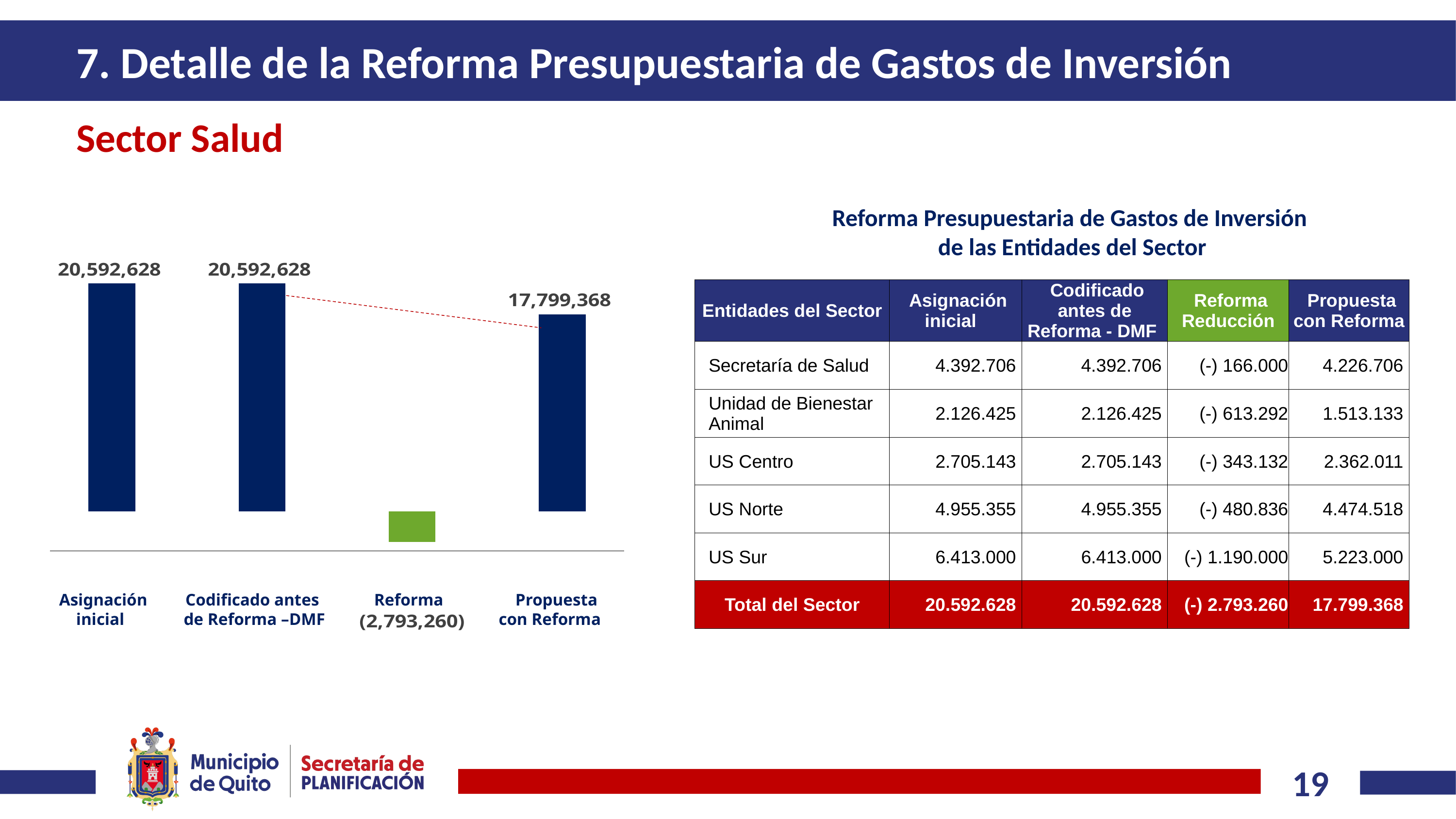
How many categories are plotted along the x axis of the chart? 4 What is the difference between the Codificado antes de Reforma –DMF value and the Propuesta con Reforma value in the chart? 2,793,260 What is the value shown for Codificado antes de Reforma –DMF in the chart? 20,592,628 Which is larger in the chart, Asignación inicial or Propuesta con Reforma? Asignación inicial Which category in the chart has the smallest bar? Reforma What is the value shown for Asignación inicial in the chart? 20,592,628 What is the value shown for Propuesta con Reforma in the chart? 17,799,368 What colour is the Reforma bar in the chart? Green What kind of chart is shown on the left of the slide? Bar chart Does the value fall or rise from Codificado antes de Reforma –DMF to Propuesta con Reforma in the chart? Fall What colour are the Asignación inicial, Codificado antes de Reforma –DMF and Propuesta con Reforma bars in the chart? Dark blue What value is printed for the Reforma bar in the chart? (2,793,260)